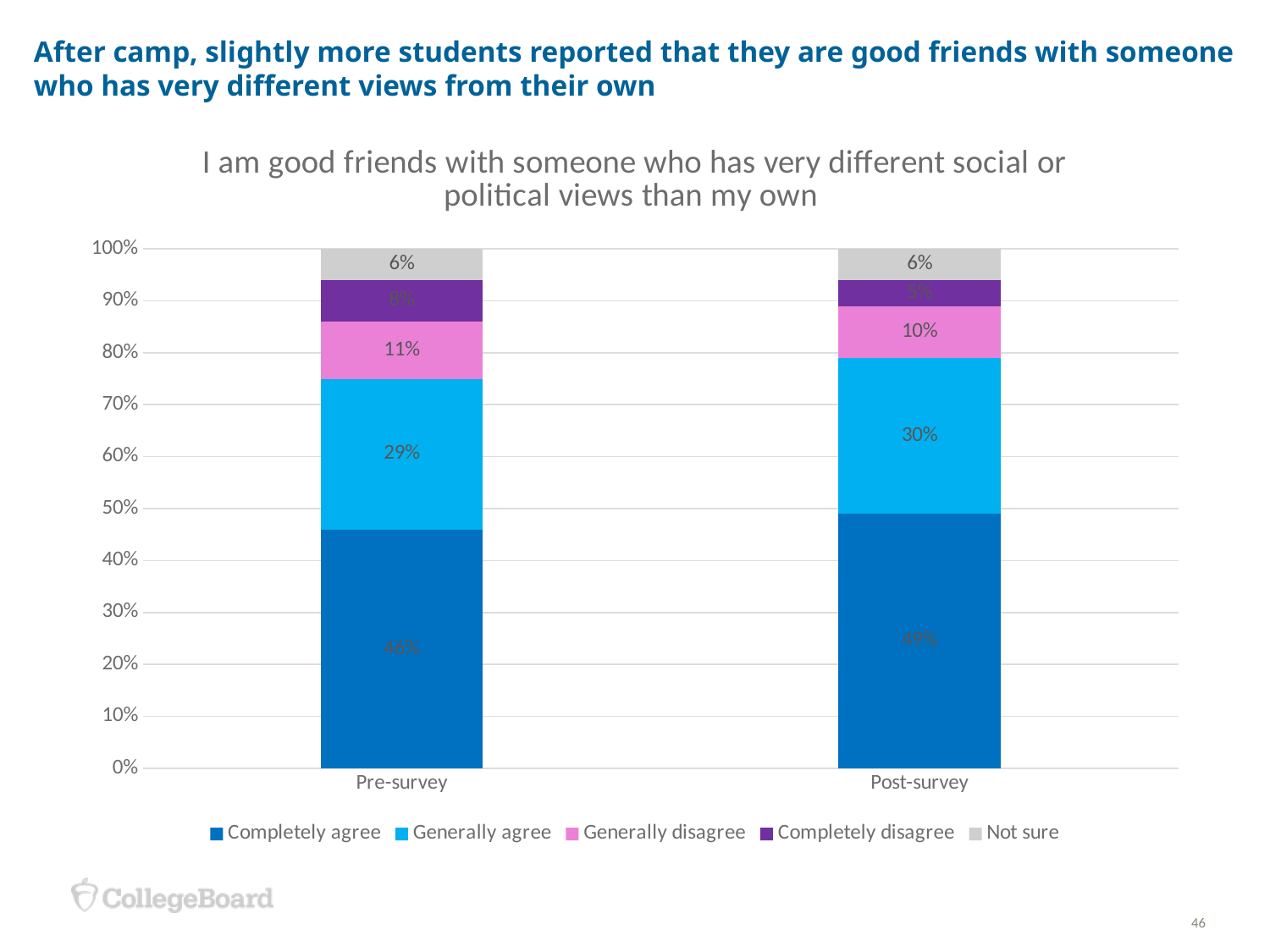
What is the difference between the "Generally agree" values for Post-survey and Pre-survey? 1% What percentage of students selected "Completely agree" in the Pre-survey? 46% What kind of chart is shown on the slide? Stacked bar chart By how many percentage points did "Completely agree" increase from Pre-survey to Post-survey? 3% How many series does the legend list? 5 What is the "Not sure" value for the Post-survey bar? 6% How many bars (survey categories) are shown on the x axis? 2 What is the "Generally disagree" value for the Pre-survey bar? 11% Which response category makes up the largest segment of the Post-survey bar? Completely agree What is the title of the chart? I am good friends with someone who has very different social or political views than my own What percentage of students selected "Generally agree" in the Post-survey? 30% Which survey has the larger "Completely agree" share, Pre-survey or Post-survey? Post-survey